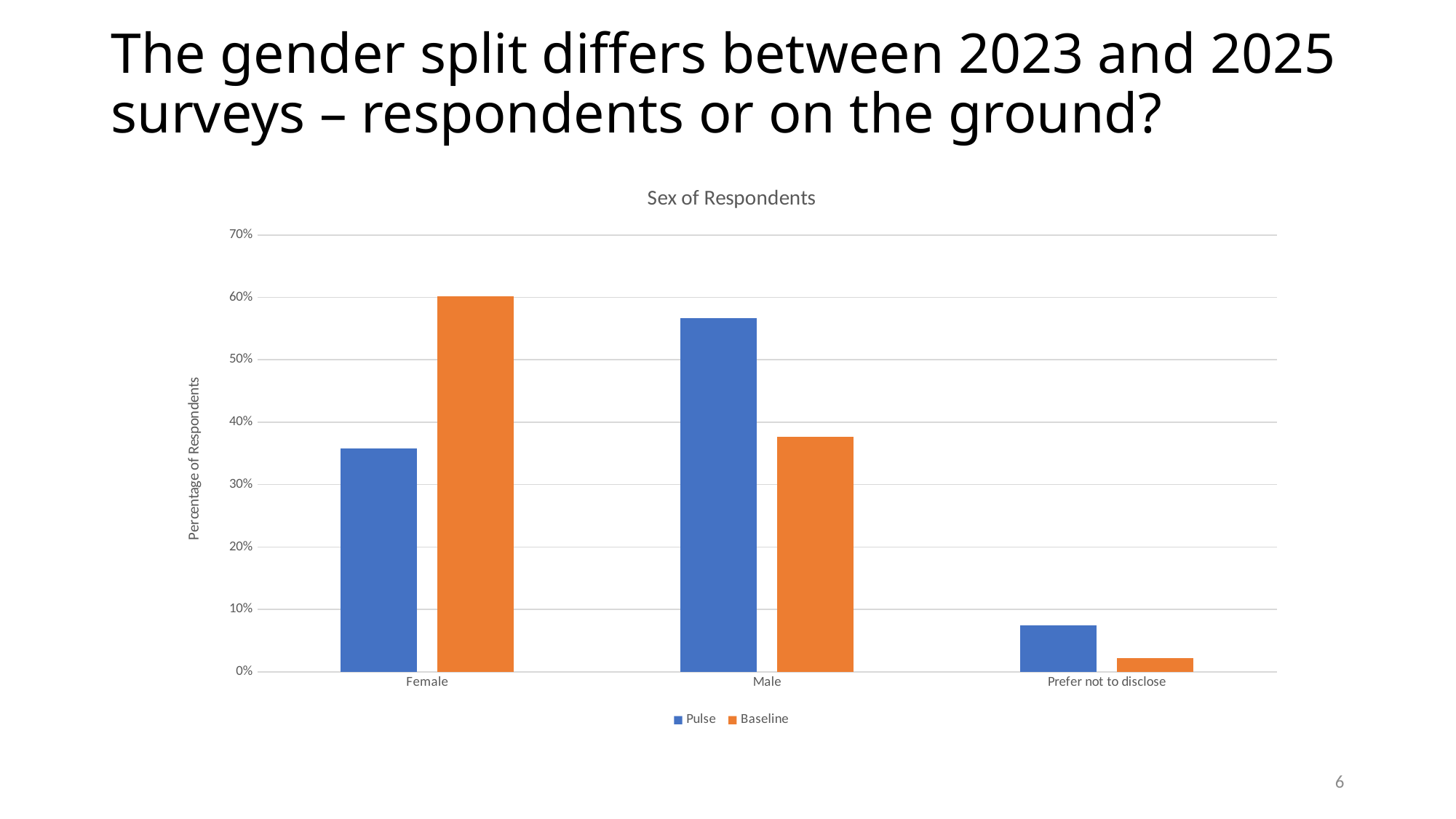
Which category has the highest Baseline value? Female How many series does the legend list? 2 What is the title of the chart? Sex of Respondents Is the Pulse value for Prefer not to disclose greater or less than 10%? less Which category has the lowest Baseline value? Prefer not to disclose For Male, which series is larger, Pulse or Baseline? Pulse Is the Pulse value for Male greater or less than 50%? greater How many categories are shown on the x axis? 3 For Female, which series is larger, Pulse or Baseline? Baseline Is the Pulse value for Female greater or less than 40%? less Which category has the highest Pulse value? Male What type of chart is shown on the slide? Bar chart